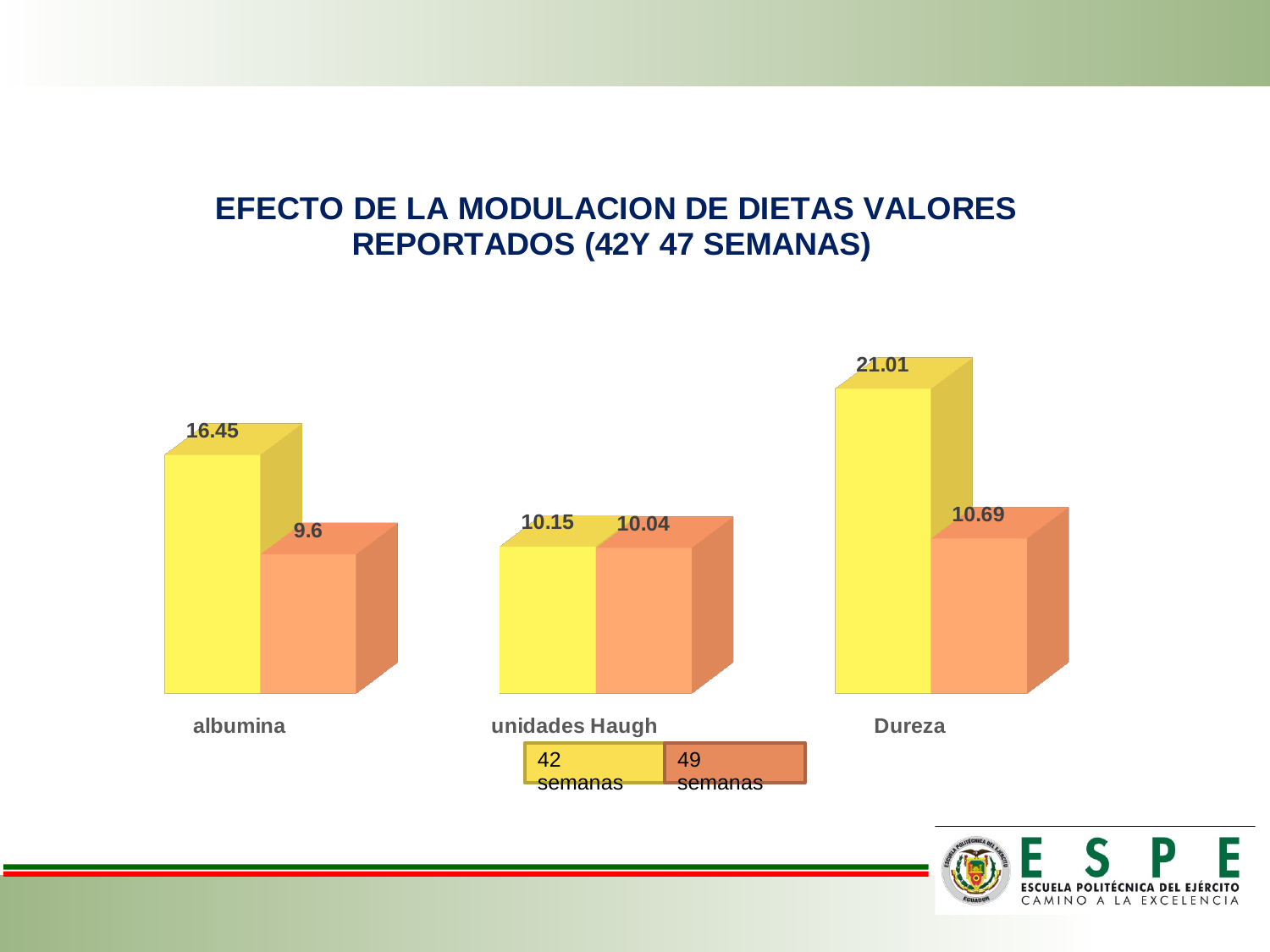
How many categories are shown on the x axis? 3 What is the value for unidades Haugh at 42 semanas? 10.15 What is the difference between the 42 semanas and 49 semanas values for Dureza? 10.32 Which category has the lowest value for the 49 semanas series? albumina What is the value for Dureza at 49 semanas? 10.69 Which is larger for albumina: the 42 semanas value or the 49 semanas value? 42 semanas What is the value for albumina at 49 semanas? 9.6 How many series does the legend list? 2 What kind of chart is shown on the slide? bar chart Which category has the highest value for the 42 semanas series? Dureza Which colour represents the 49 semanas series? orange What is the value for albumina at 42 semanas? 16.45